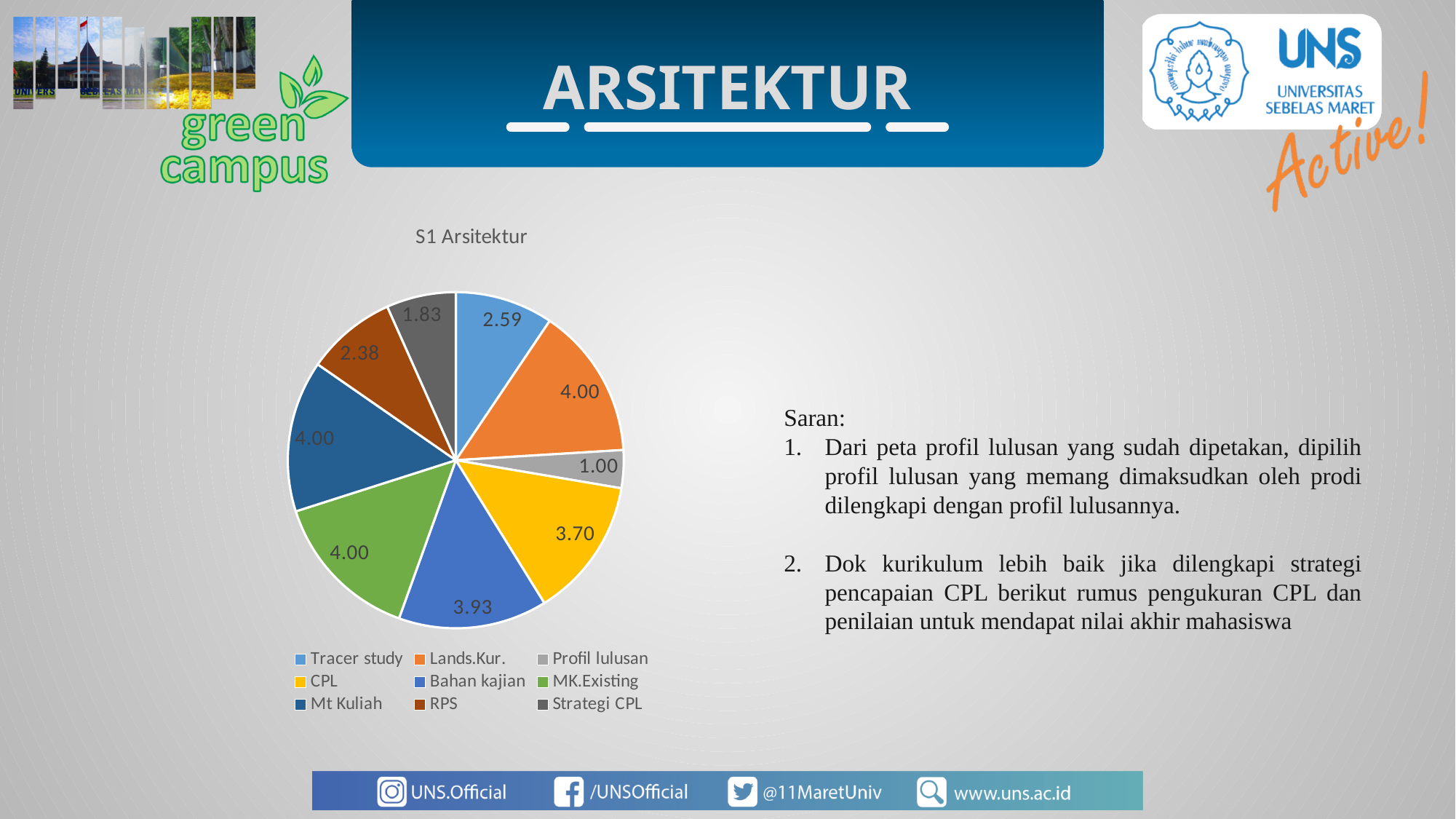
Which is larger, the value for Bahan kajian or the value for CPL? Bahan kajian What type of chart is shown on the slide? Pie chart What is the value for Strategi CPL? 1.83 What is the difference between the values for Lands.Kur. and Tracer study? 1.41 What is the value for Bahan kajian? 3.93 How many categories does the pie chart have? 9 What is the title of the chart? S1 Arsitektur What is the value for CPL? 3.70 What is the difference between the values for RPS and Strategi CPL? 0.55 What is the value for RPS? 2.38 Which category has the smallest slice? Profil lulusan What is the value for Tracer study? 2.59